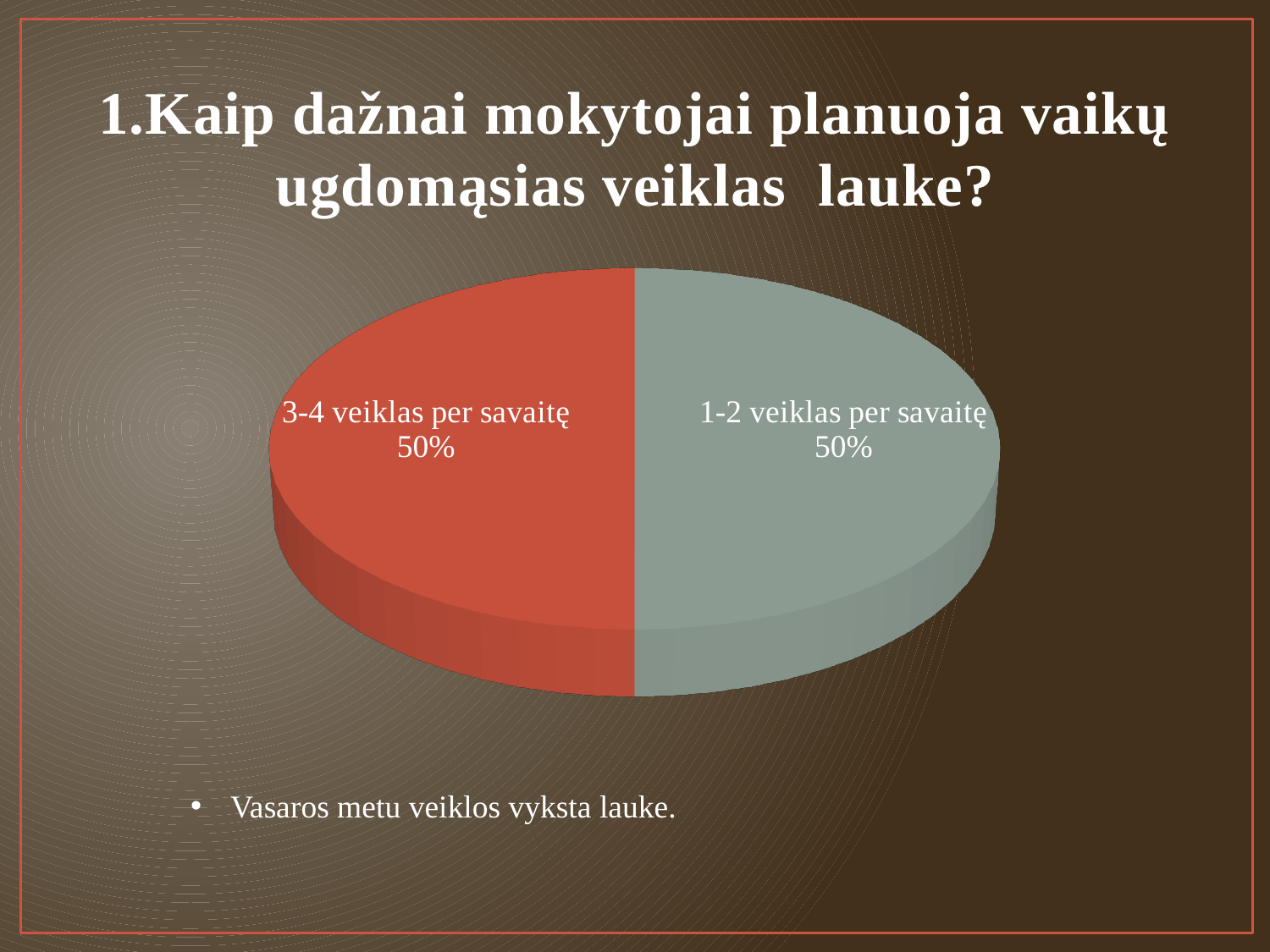
What share of the pie does "1-2 veiklas per savaitę" have? 50% How many slices does the pie chart have? 2 What share of the pie does "3-4 veiklas per savaitę" have? 50% What kind of chart is shown on the slide? pie chart What is the combined share of the two slices in the pie chart? 100% Which slice of the pie chart is coloured grey-green? 1-2 veiklas per savaitę Is the share for "1-2 veiklas per savaitę" equal to the share for "3-4 veiklas per savaitę"? yes What is the difference between the shares of "3-4 veiklas per savaitę" and "1-2 veiklas per savaitę"? 0% Which slice of the pie chart is coloured red? 3-4 veiklas per savaitę